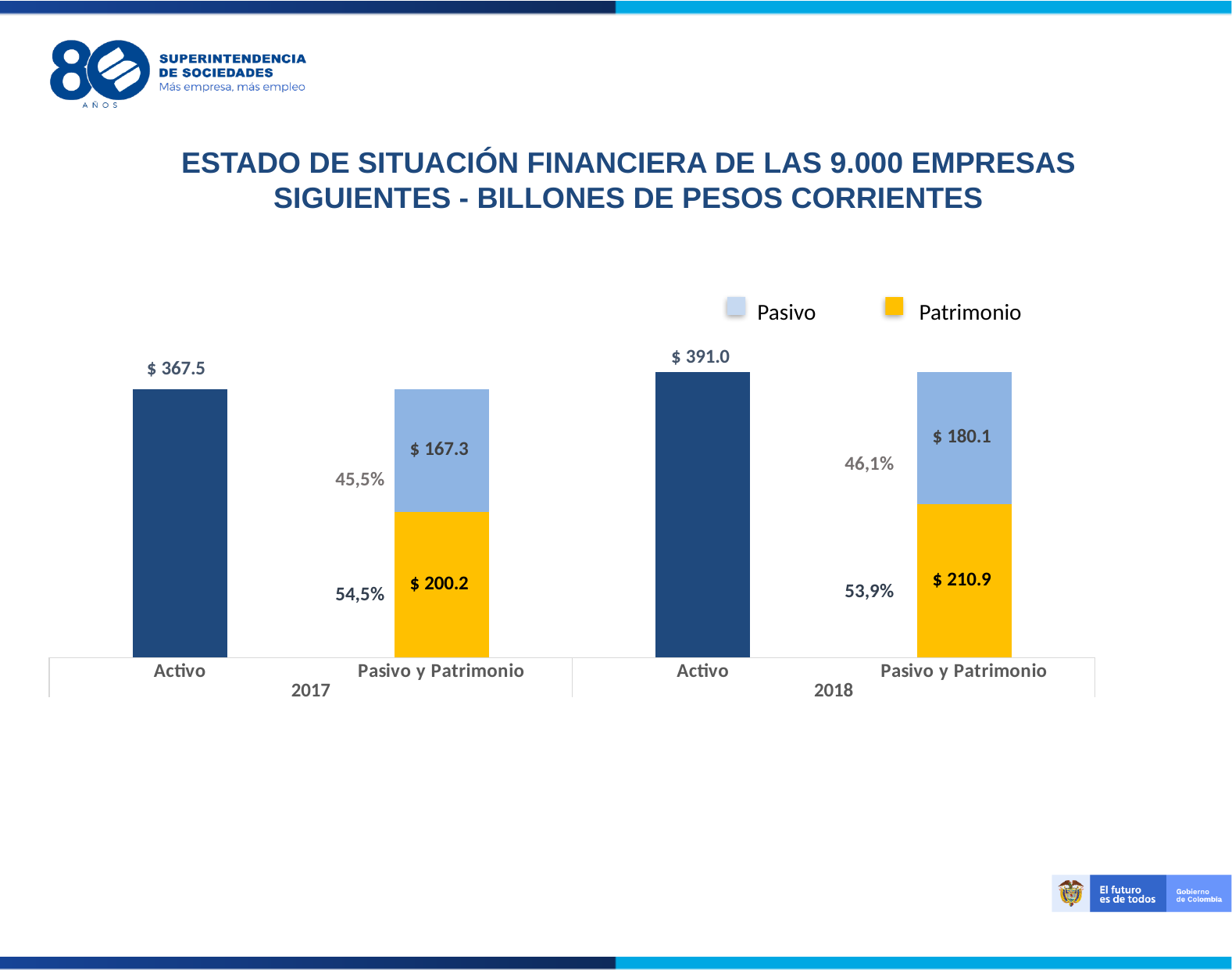
What is the Pasivo value in the 2017 Pasivo y Patrimonio bar? $ 167.3 What is the value of Activo for 2018? $ 391.0 What percentage share is shown for Patrimonio in 2017? 54,5% What is the Patrimonio value in the 2018 Pasivo y Patrimonio bar? $ 210.9 How many series does the legend list? 2 Which is larger in 2018, Pasivo or Patrimonio? Patrimonio Does the Activo value rise or fall from 2017 to 2018? rise What is the difference between Patrimonio and Pasivo in 2017? $ 32.9 What is the value of Activo for 2017? $ 367.5 What is the difference between Activo in 2018 and Activo in 2017? $ 23.5 What kind of chart is shown on the slide? bar chart What percentage share is shown for Pasivo in 2018? 46,1%